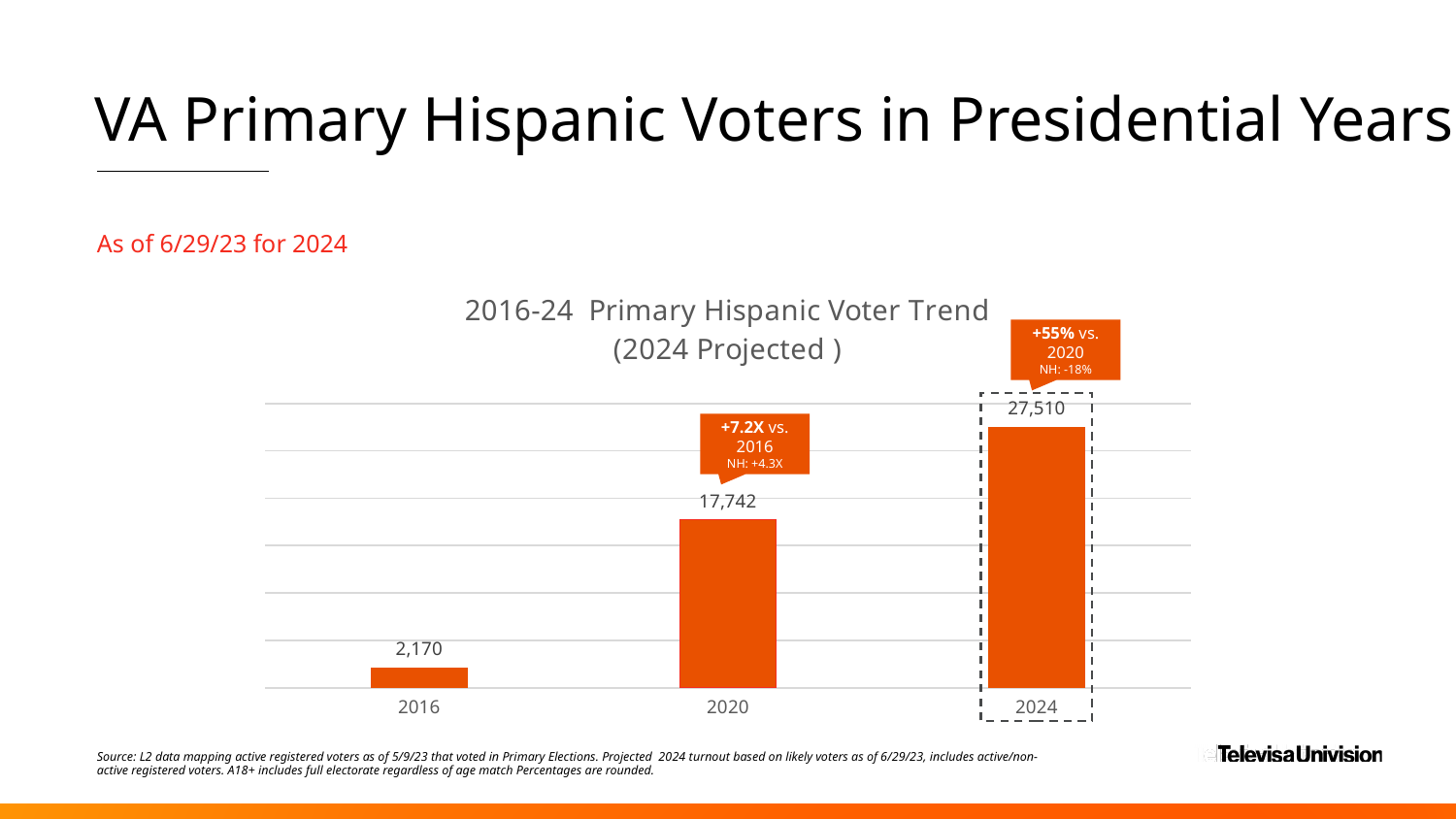
What is the projected value for 2024? 27,510 Which year has the lowest value? 2016 What is the difference between the 2020 and 2016 values? 15,572 What is the title of the chart? 2016-24 Primary Hispanic Voter Trend (2024 Projected ) How many years are shown on the chart? 3 What is the value for 2020? 17,742 Do the values rise or fall from 2016 to 2024? Rise What kind of chart is this? Bar chart Which year has the highest value? 2024 What is the value for 2016? 2,170 Which is larger, the value for 2020 or the value for 2016? 2020 What is the difference between the 2024 and 2020 values? 9,768